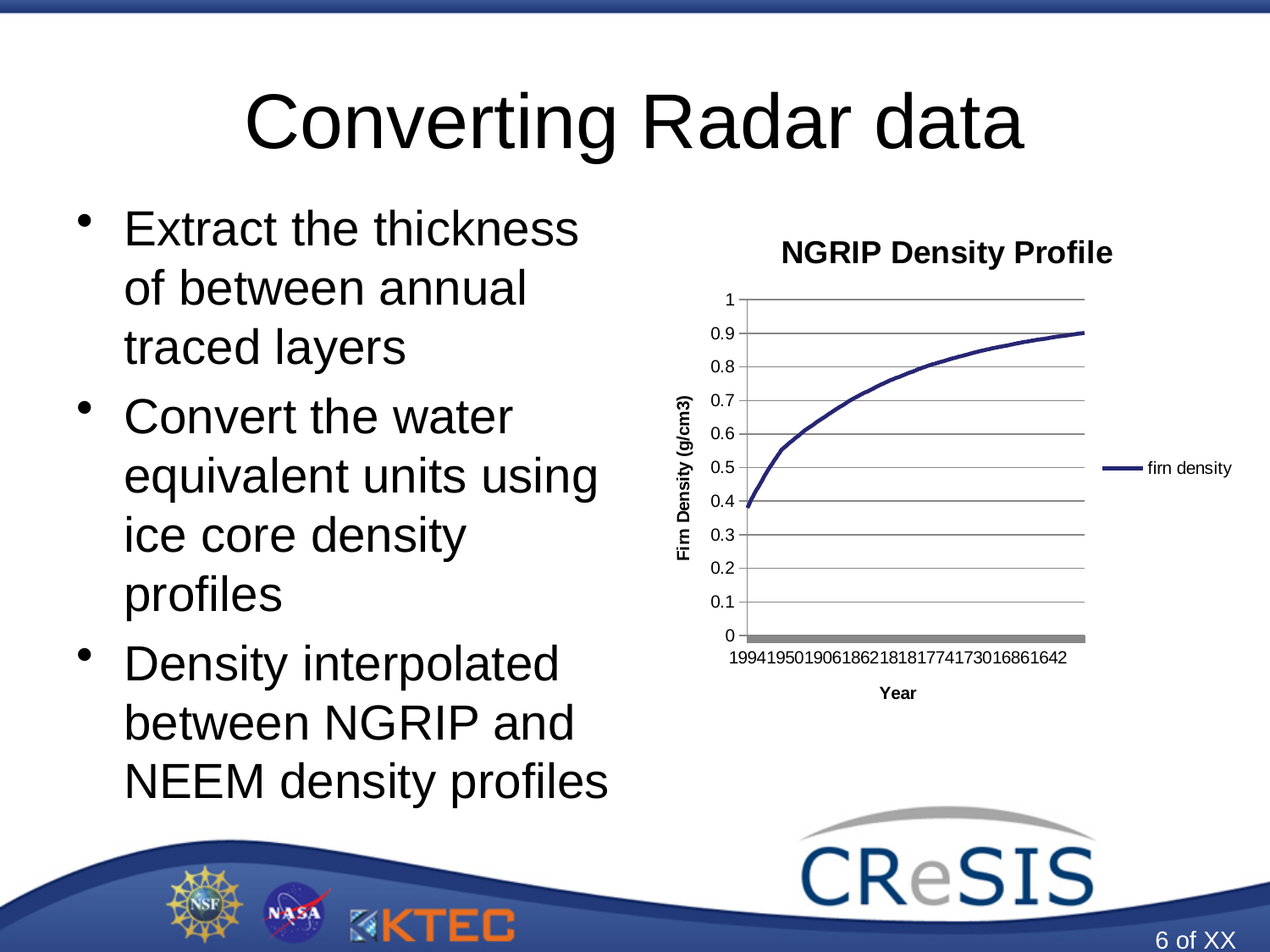
How many series does the legend of the NGRIP Density Profile chart list? 1 Is the firn density value at the rightmost point (year 1642) greater or less than 0.8? greater Is the firn density value at year 1818 greater or less than 0.7? greater What kind of chart is the NGRIP Density Profile? line chart What is the name of the series shown in the legend of the NGRIP Density Profile chart? firn density Does the firn density rise or fall moving from left to right along the x axis of the NGRIP Density Profile chart? rise Is the firn density value at the leftmost point (year 1994) greater or less than 0.5? less Which has the larger firn density in the NGRIP Density Profile chart, year 1994 or year 1642? 1642 What is the maximum value shown on the y axis of the NGRIP Density Profile chart? 1 What is the title of the chart on the slide? NGRIP Density Profile How many year labels are printed along the x axis of the NGRIP Density Profile chart? 9